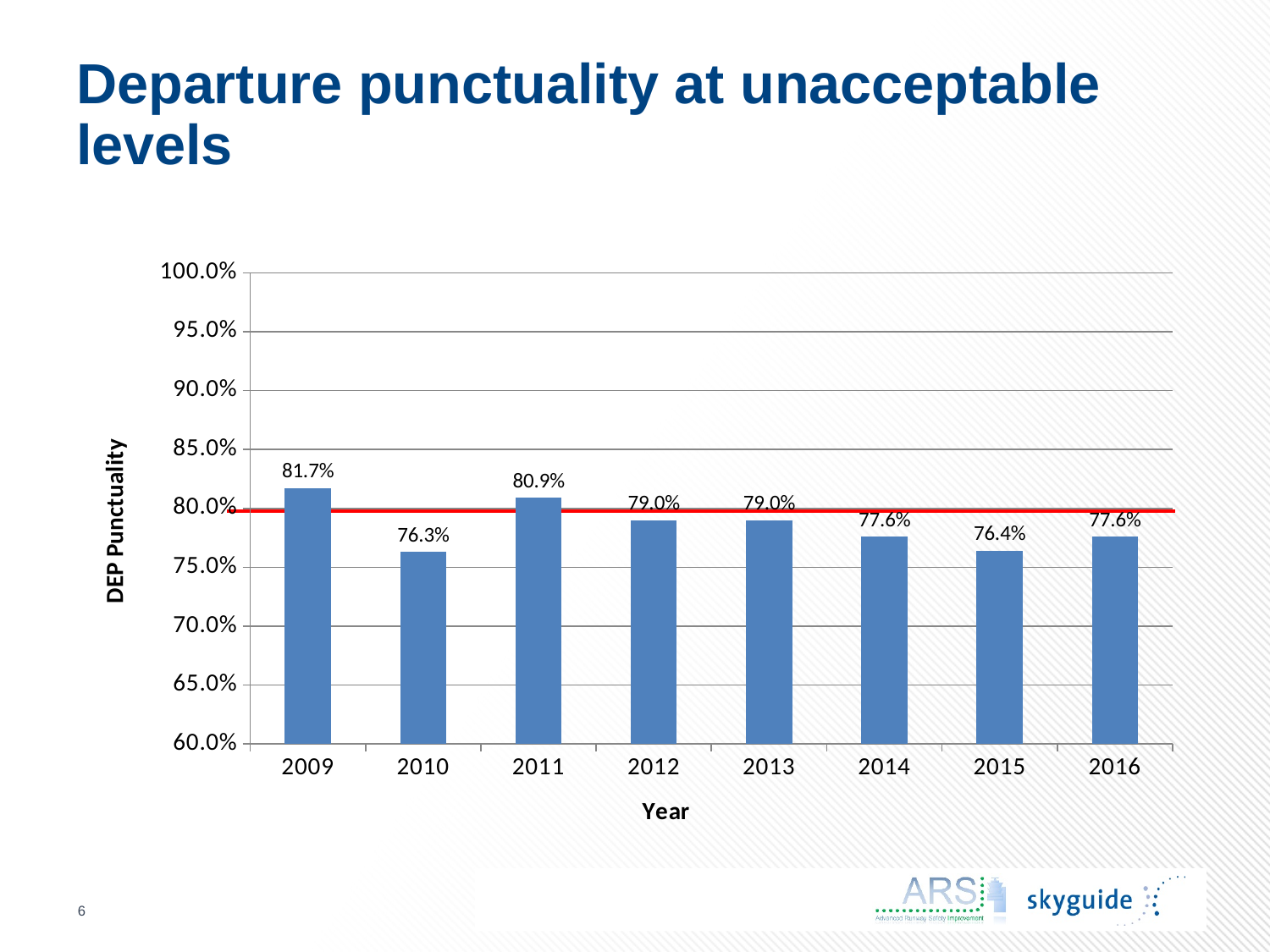
Which year has a higher DEP Punctuality, 2011 or 2014? 2011 Which year has the lowest DEP Punctuality? 2010 What is the DEP Punctuality value for 2015? 76.4% What is the label of the y axis of the chart? DEP Punctuality What is the difference in DEP Punctuality between 2009 and 2010? 5.4% How many years are shown on the x axis of the chart? 8 Is the DEP Punctuality value for 2013 greater or less than 80.0%? less Which year has the highest DEP Punctuality? 2009 What is the DEP Punctuality value for 2009? 81.7% What is the DEP Punctuality value for 2012? 79.0% What kind of chart is shown on the slide? bar chart What is the label of the x axis of the chart? Year